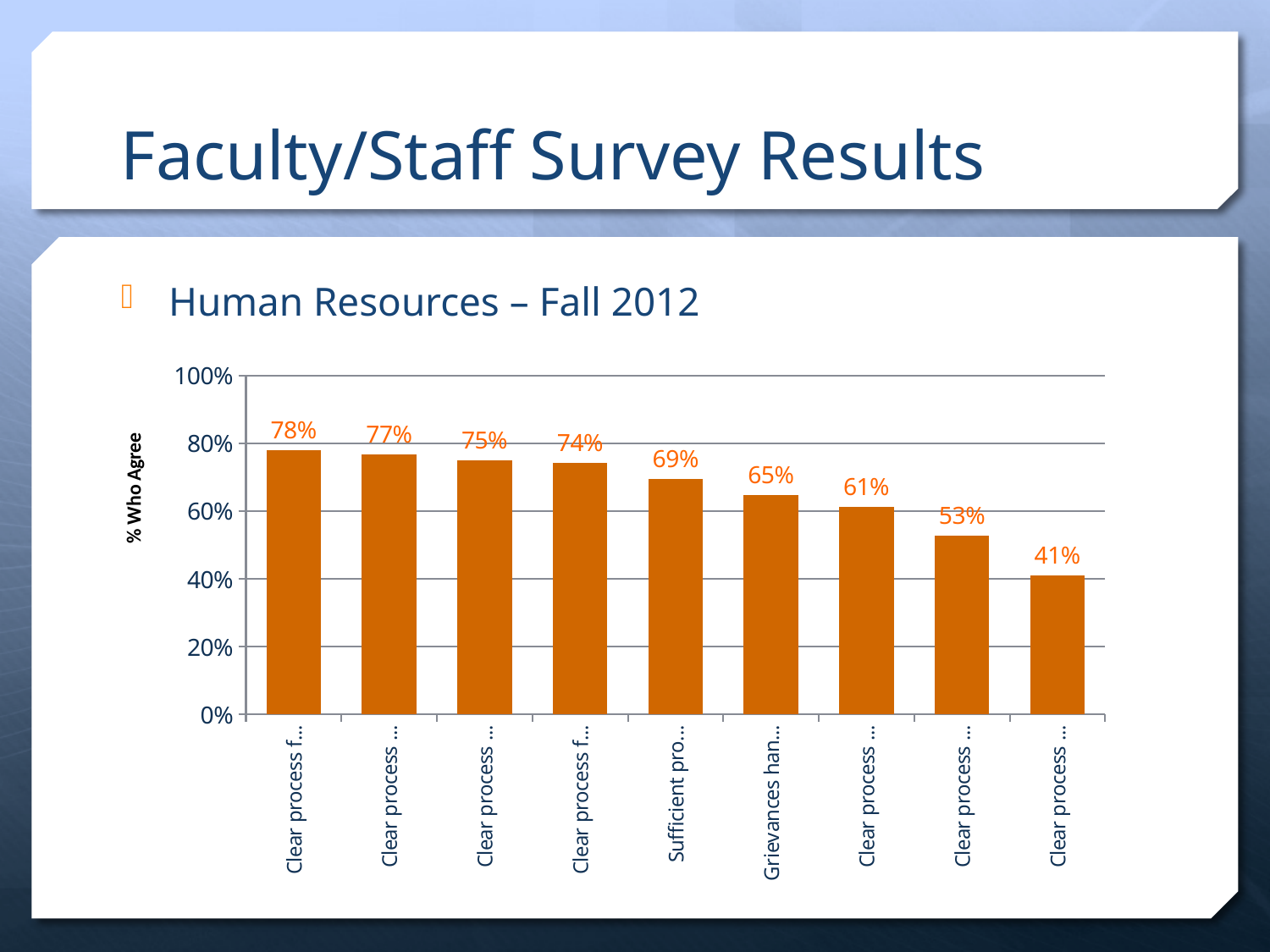
What is the value of the last (rightmost) bar in the chart? 41% What is the highest value shown in the chart? 78% What is the difference between the highest and lowest values in the chart? 37% What kind of chart is shown on the slide? bar chart What is the lowest value shown in the chart? 41% What is the value of the first (leftmost) bar in the chart? 78% What is the value of the fifth bar from the left in the chart? 69% What is the label on the vertical axis of the chart? % Who Agree Do the values rise or fall moving from left to right along the x axis? fall How many bars are plotted in the chart? 9 Which is larger, the value of the sixth bar from the left or the seventh bar from the left? the sixth bar (65%) What is the difference between the second bar (77%) and the eighth bar (53%)? 24%